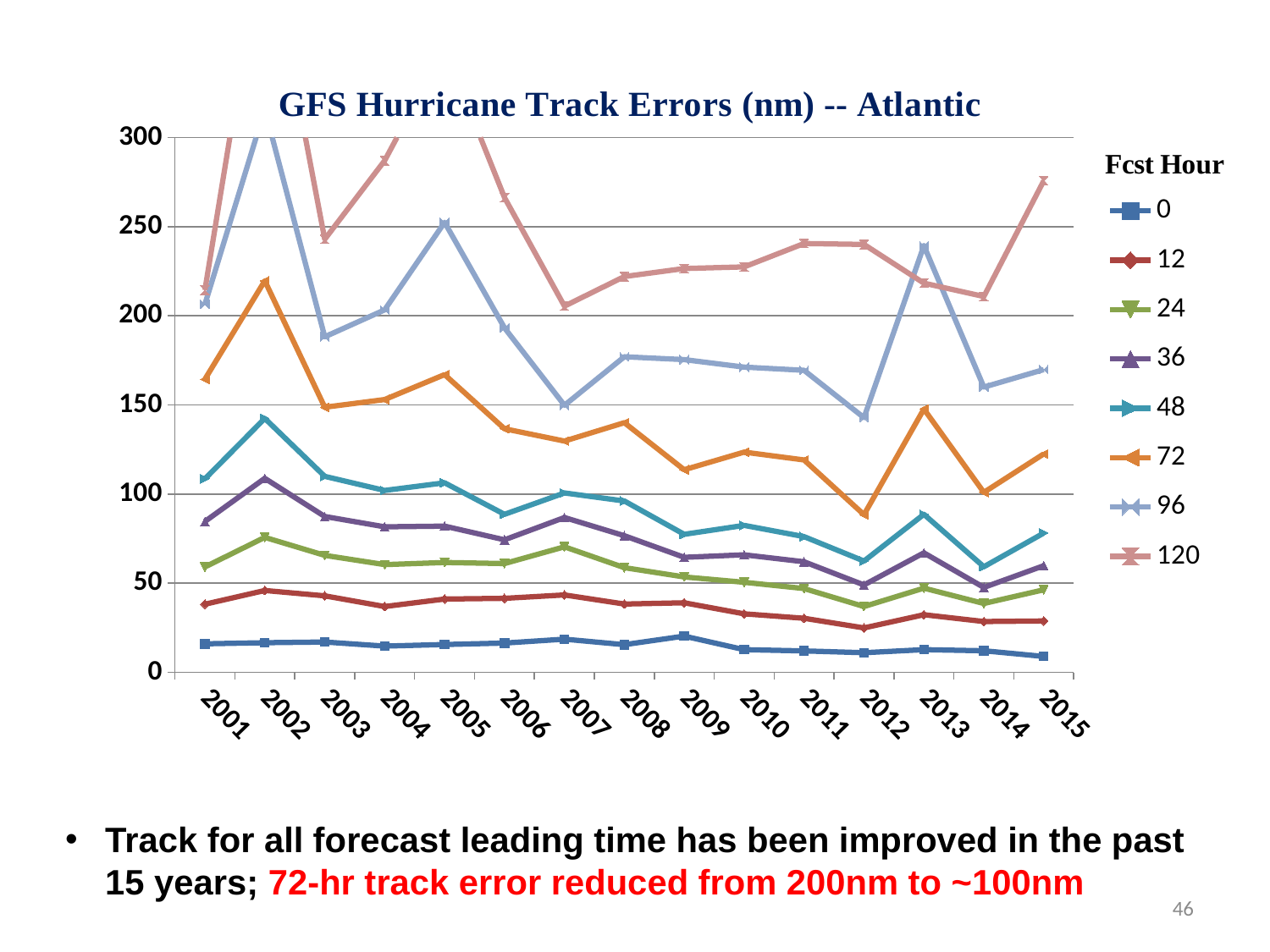
Which forecast hour has the highest track error in 2015? 120 What kind of chart is shown on the slide? line chart How many years are plotted along the x axis? 15 Does the track error for the 0 forecast hour generally rise or fall from 2001 to 2015? fall Is the value for the 72 forecast hour in 2012 greater or less than 100? less Which forecast hour has the lowest track error in 2015? 0 What is the title of the chart? GFS Hurricane Track Errors (nm) -- Atlantic Is the value for the 72 forecast hour in 2002 greater or less than 200? greater Is the value for the 120 forecast hour in 2015 greater or less than 250? greater How many series does the legend list? 8 What is the title of the legend? Fcst Hour